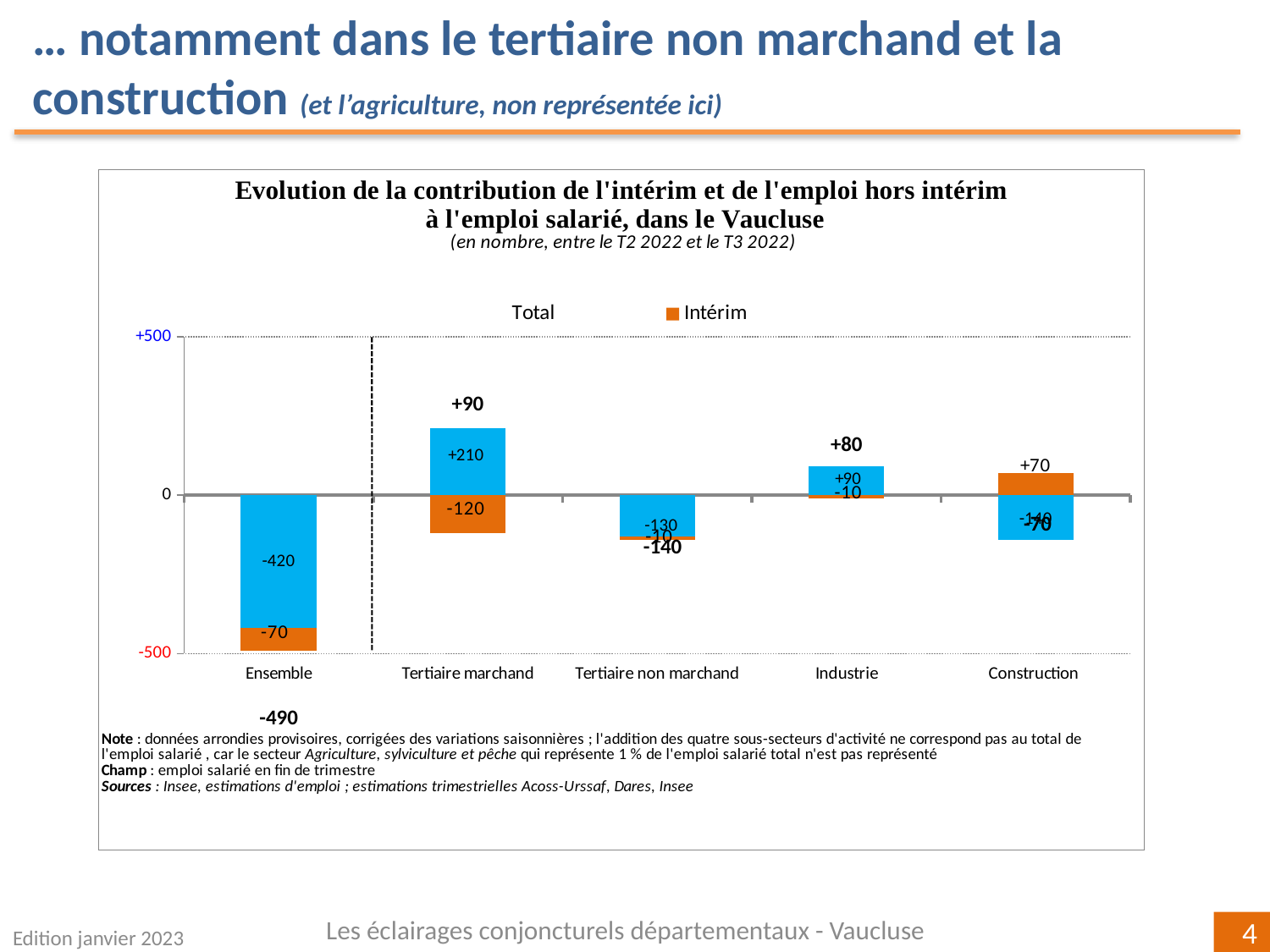
What is the Intérim value for Construction? +70 Which colour represents the Intérim series in the chart? orange What is the total value shown for Tertiaire non marchand? -140 What is the total value shown for Ensemble? -490 Which sector has the highest total value? Tertiaire marchand Which category has the lowest total value? Ensemble What is the total value shown for Industrie? +80 What is the Intérim value for Tertiaire marchand? -120 What is the difference between the total for Tertiaire marchand and the total for Industrie? 10 How many series does the chart legend list? 2 What kind of chart is shown on the slide? bar chart How many sectors (categories) are shown on the x axis of the chart? 5